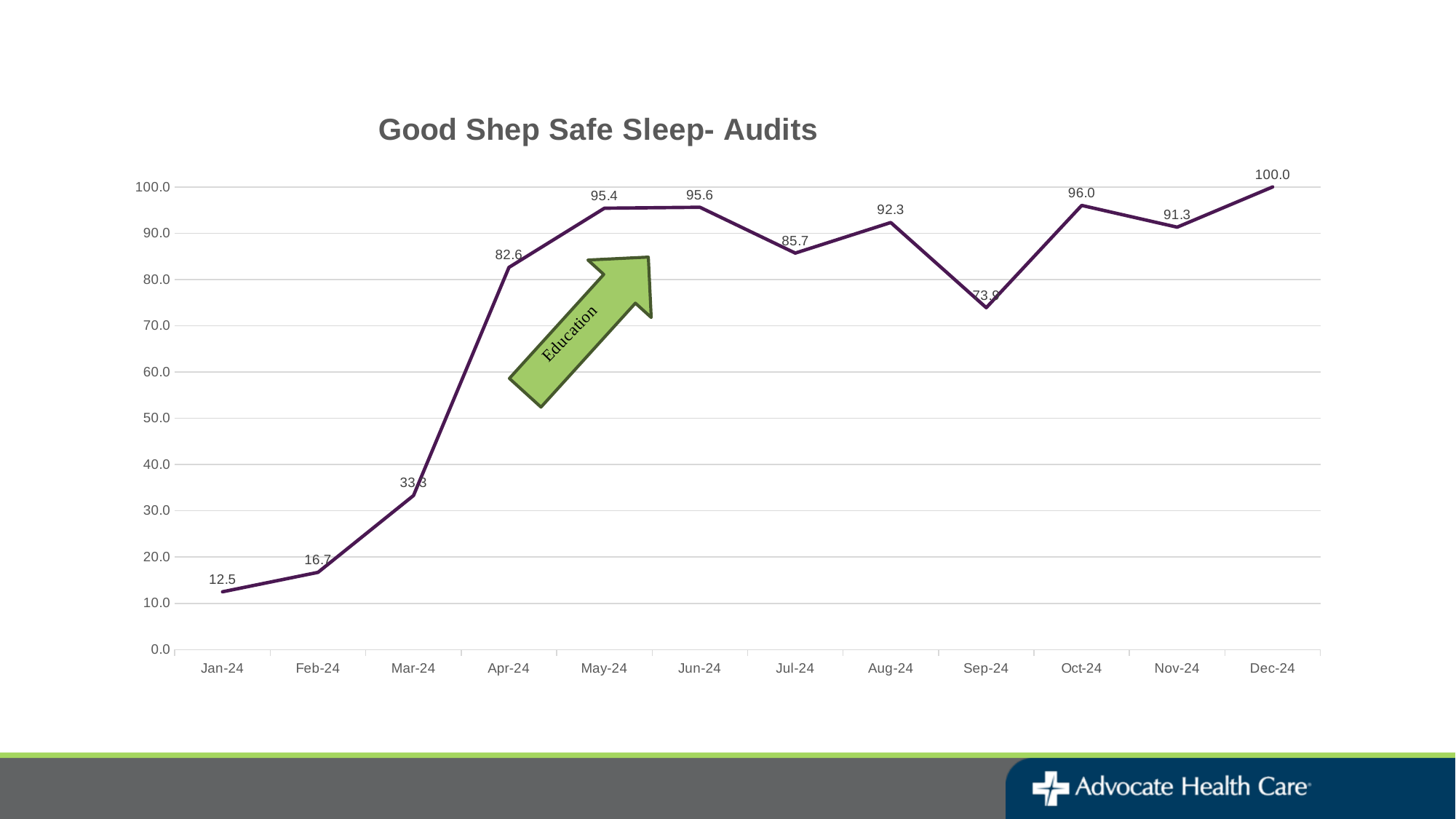
What is the title of the chart? Good Shep Safe Sleep- Audits Which month has the lowest value? Jan-24 How many months are plotted on the x axis? 12 What is the value for Jan-24? 12.5 Which is larger, the value for Aug-24 or the value for Nov-24? Aug-24 Is the value for Sep-24 greater or less than 80.0? less What kind of chart is this? line chart What is the difference between the values for Jun-24 and Jul-24? 9.9 What is the value for Oct-24? 96.0 Do the values rise or fall from Jan-24 to Apr-24? rise What is the value for Apr-24? 82.6 Which month has the highest value? Dec-24